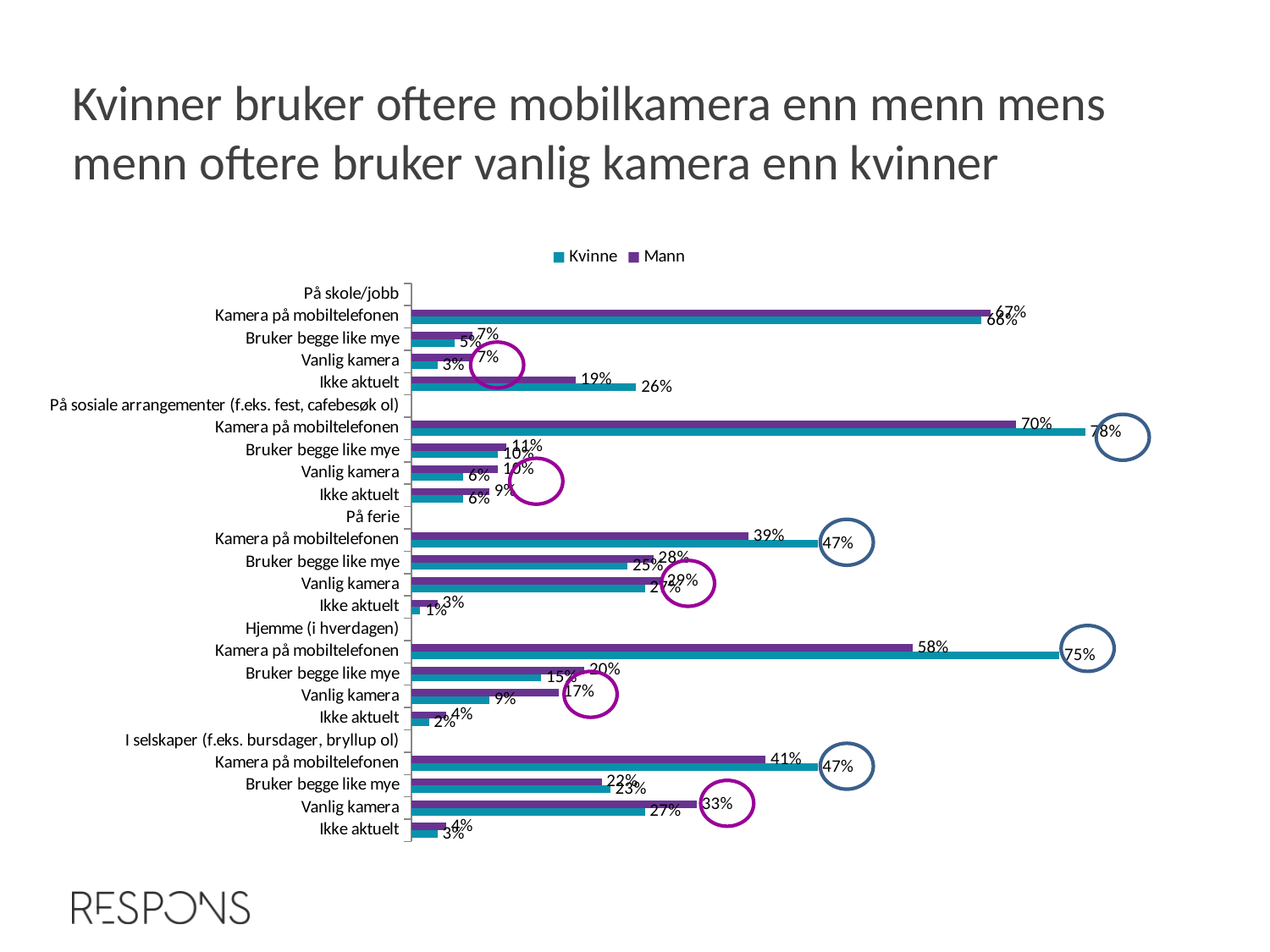
What is the difference between Mann and Kvinne for 'Vanlig kamera' under 'I selskaper (f.eks. bursdager, bryllup ol)'? 6% What is the value for Kvinne for 'Kamera på mobiltelefonen' under 'På sosiale arrangementer'? 78% What kind of chart is shown on the slide? bar chart Which two series are listed in the legend? Kvinne and Mann Under 'Hjemme (i hverdagen)', which series has the larger value for 'Vanlig kamera', Kvinne or Mann? Mann What is the value for Mann for 'Kamera på mobiltelefonen' under 'Hjemme (i hverdagen)'? 58% Under 'På ferie', which series has the larger value for 'Kamera på mobiltelefonen', Kvinne or Mann? Kvinne How many series does the legend list? 2 What is the difference between Kvinne and Mann for 'Kamera på mobiltelefonen' under 'Hjemme (i hverdagen)'? 17% What is the value for Kvinne for 'Kamera på mobiltelefonen' under 'På ferie'? 47% What is the value for Mann for 'Vanlig kamera' under 'I selskaper (f.eks. bursdager, bryllup ol)'? 33% What is the value for Kvinne for 'Ikke aktuelt' under 'På skole/jobb'? 26%